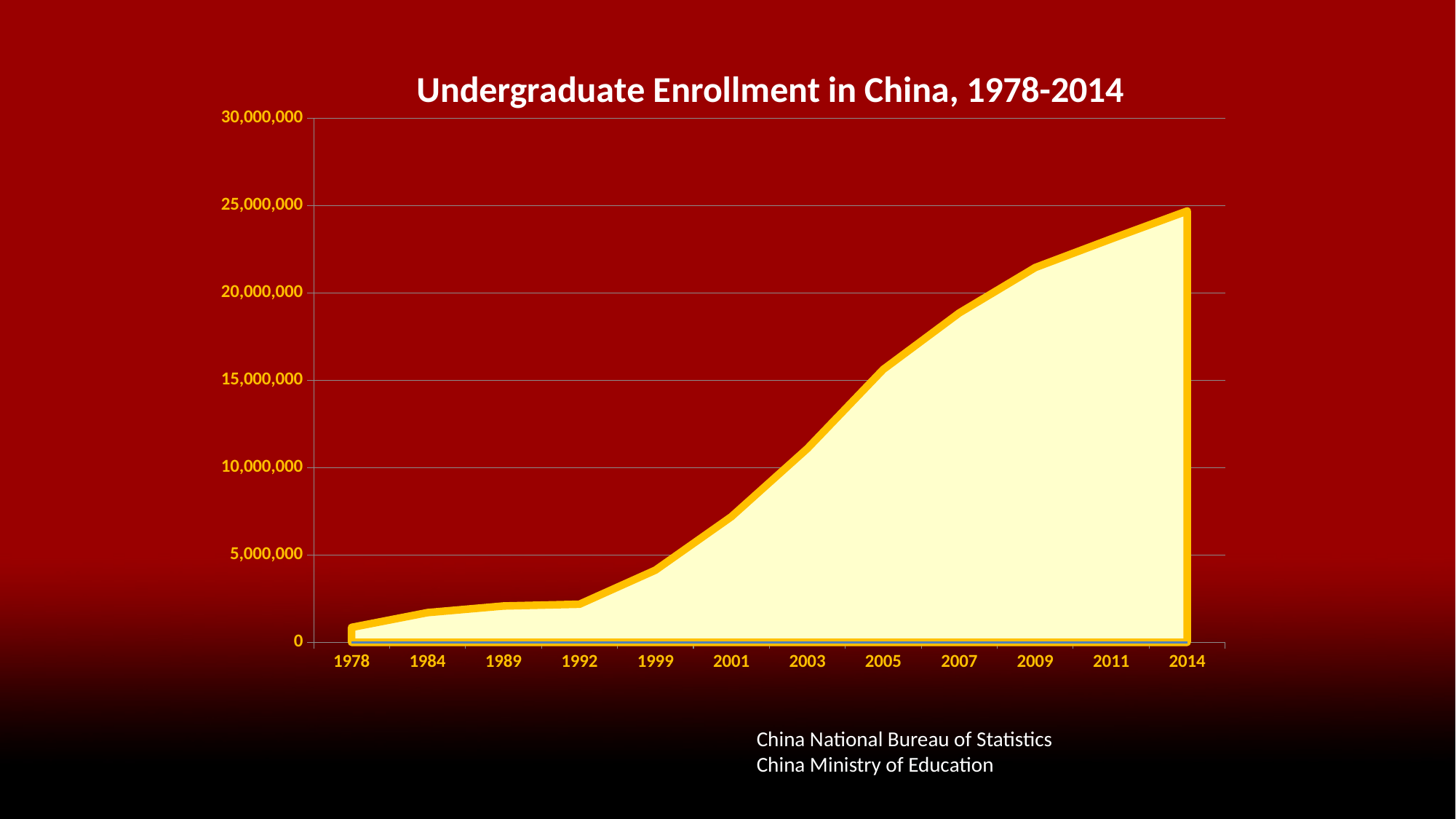
Is the value for 1999 greater or less than 5,000,000? less Which is larger, the enrollment in 2005 or in 1992? 2005 Is the value for 2001 greater or less than 10,000,000? less What kind of chart is shown on the slide? area chart Which year has the highest undergraduate enrollment? 2014 Is the value for 2009 greater or less than 20,000,000? greater Which year has the lowest undergraduate enrollment? 1978 How many years are plotted along the x axis? 12 What is the title of the chart? Undergraduate Enrollment in China, 1978-2014 Do the values rise or fall from 1978 to 2014? rise